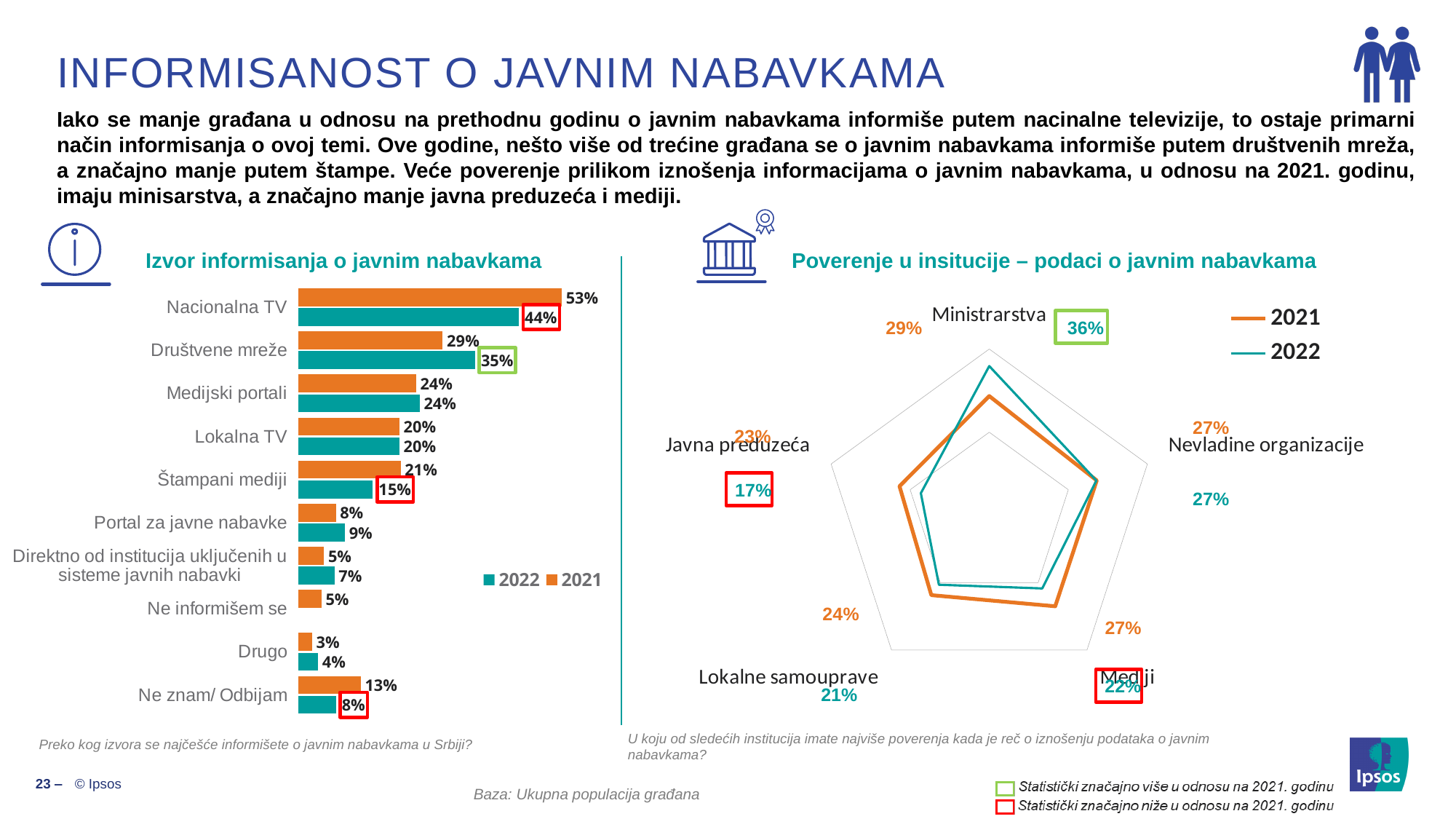
How many institutions are shown in the radar chart 'Poverenje u insitucije – podaci o javnim nabavkama'? 5 In the radar chart 'Poverenje u insitucije – podaci o javnim nabavkama', what is the 2022 value for Ministrarstva? 36% In the radar chart 'Poverenje u insitucije – podaci o javnim nabavkama', what is the difference between the 2021 and 2022 values for Javna preduzeća? 6% In the bar chart 'Izvor informisanja o javnim nabavkama', what is the difference between the 2021 and 2022 values for Nacionalna TV? 9% How many categories are shown in the bar chart 'Izvor informisanja o javnim nabavkama'? 10 How many series does the legend of the bar chart 'Izvor informisanja o javnim nabavkama' list? 2 In the bar chart 'Izvor informisanja o javnim nabavkama', what is the 2022 value for Nacionalna TV? 44% In the bar chart 'Izvor informisanja o javnim nabavkama', which category has the lowest 2021 value? Drugo What kind of chart is 'Poverenje u insitucije – podaci o javnim nabavkama'? Radar chart In the bar chart 'Izvor informisanja o javnim nabavkama', which category has the highest 2022 value? Nacionalna TV In the bar chart 'Izvor informisanja o javnim nabavkama', what is the 2021 value for Društvene mreže? 29% In the bar chart 'Izvor informisanja o javnim nabavkama', is the 2022 value for Štampani mediji larger or smaller than the 2021 value? smaller